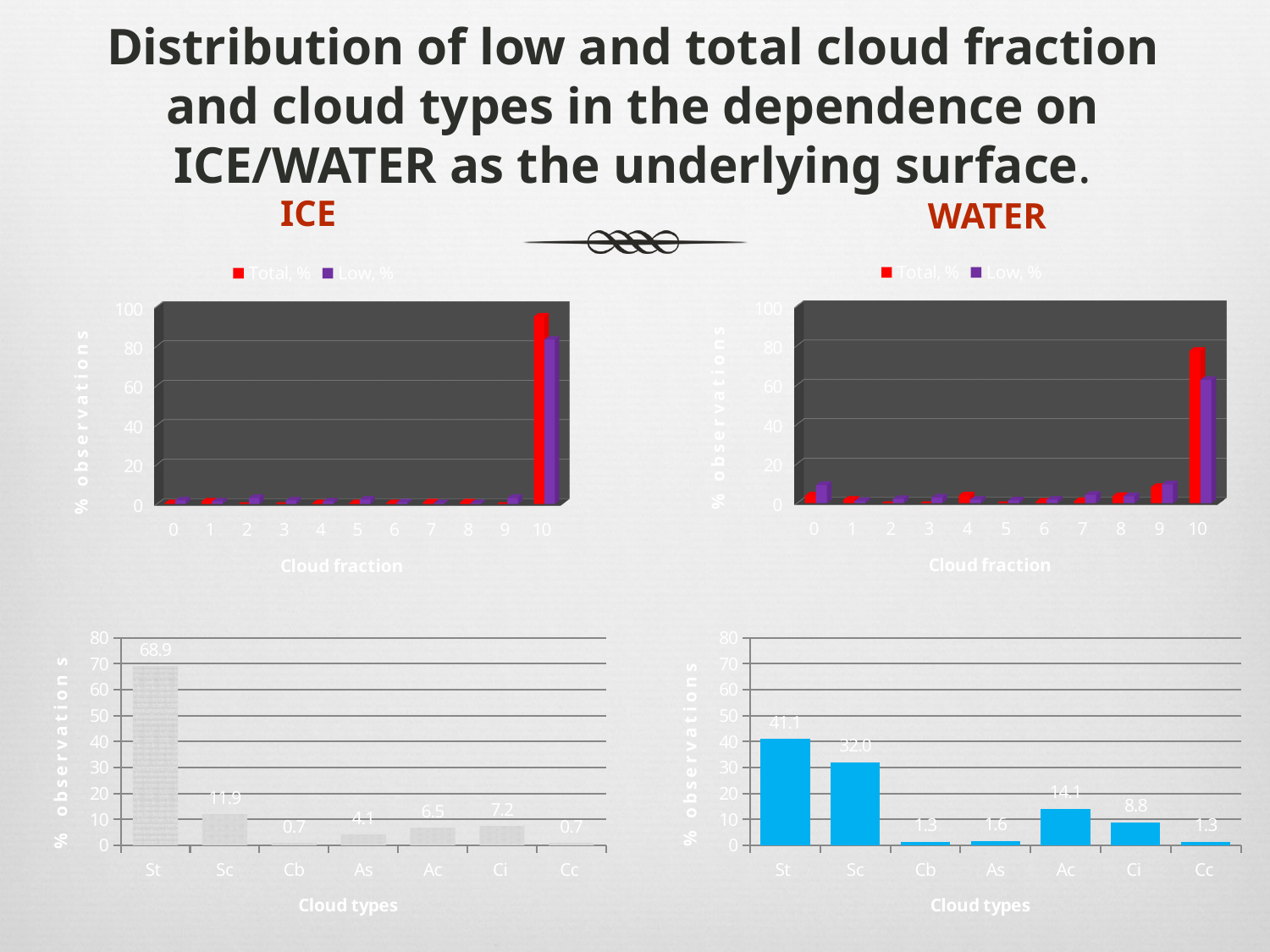
In the top-left ICE cloud fraction chart, is the Total, % value at cloud fraction 10 greater or less than 80? greater In the bottom-right WATER cloud types chart, what is the value for Sc? 32.0 In the bottom-right WATER cloud types chart, what is the difference between the values for St and Sc? 9.1 In the bottom-left ICE cloud types chart, which cloud type has the highest value? St In the bottom-right WATER cloud types chart, what is the value for Ac? 14.1 In the top-right WATER cloud fraction chart, is the Low, % value at cloud fraction 10 greater or less than 40? greater How many cloud types are shown on the x axis of the bottom-left ICE cloud types chart? 7 In the bottom-left ICE cloud types chart, which is larger, the value for Ac or the value for Ci? Ci In the bottom-left ICE cloud types chart, what is the value for St? 68.9 How many series does the legend of the top-right WATER cloud fraction chart list? 2 In the bottom-left ICE cloud types chart, what is the difference between the values for St and Sc? 57.0 In the bottom-right WATER cloud types chart, which cloud type has the lowest value among Cb, As and Ac? Cb